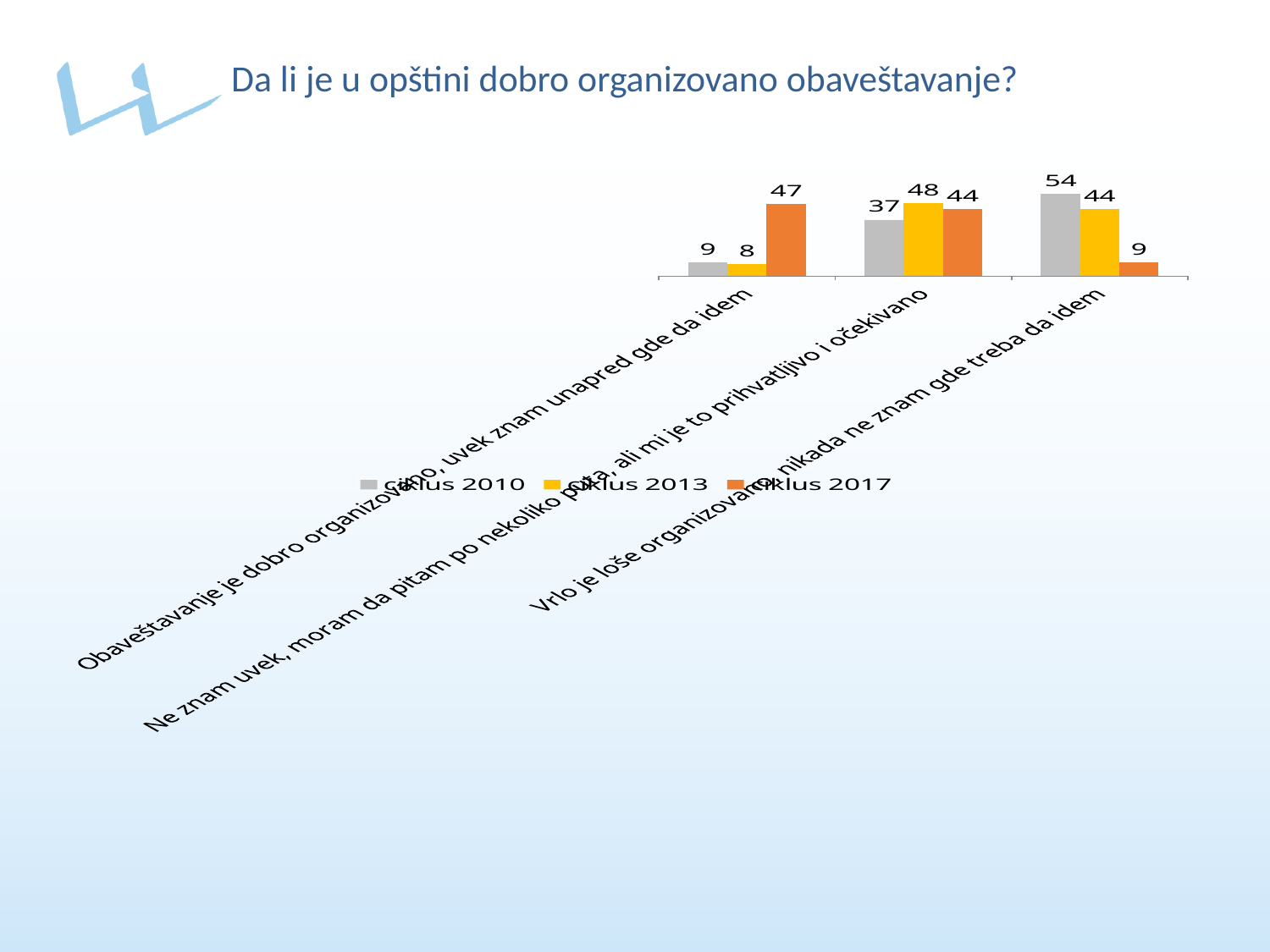
How many series does the legend list? 3 Which category has the highest value for ciklus 2010? Vrlo je loše organizovano, nikada ne znam gde treba da idem How many categories are shown on the x axis? 3 What is the value for ciklus 2017 in the category "Obaveštavanje je dobro organizovano, uvek znam unapred gde da idem"? 47 In the category "Vrlo je loše organizovano, nikada ne znam gde treba da idem", which is larger: ciklus 2010 or ciklus 2013? ciklus 2010 What is the value for ciklus 2010 in the category "Vrlo je loše organizovano, nikada ne znam gde treba da idem"? 54 Which series is shown in orange in the legend? ciklus 2017 What is the difference between the ciklus 2017 and ciklus 2010 values in the category "Obaveštavanje je dobro organizovano, uvek znam unapred gde da idem"? 38 What is the value for ciklus 2013 in the middle category ("Ne znam uvek, moram da pitam po nekoliko puta...")? 48 Which category has the lowest value for ciklus 2013? Obaveštavanje je dobro organizovano, uvek znam unapred gde da idem What kind of chart is shown on the slide? bar chart What is the value for ciklus 2017 in the category "Vrlo je loše organizovano, nikada ne znam gde treba da idem"? 9